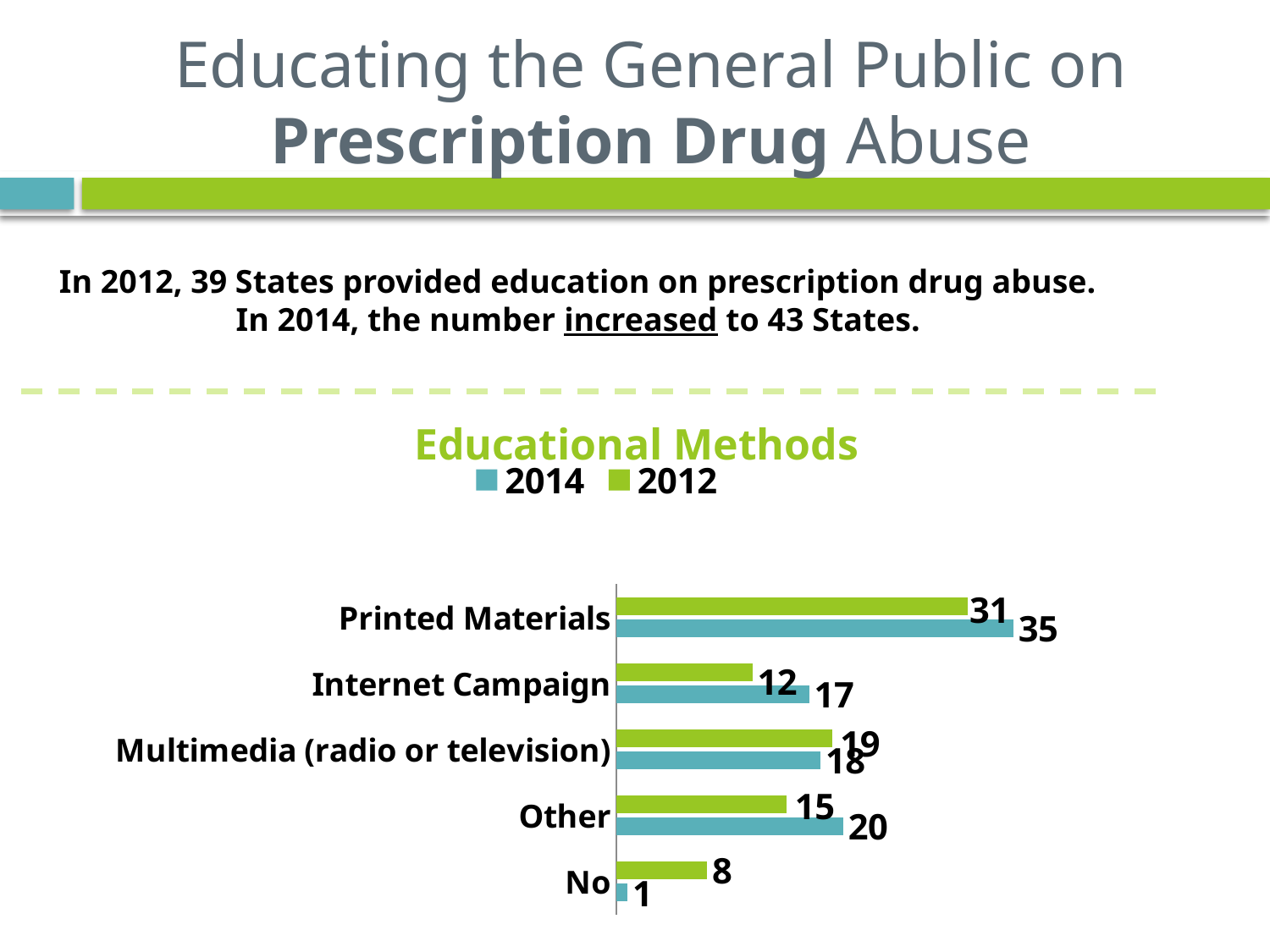
How many categories are shown in the Educational Methods chart? 5 What is the 2012 value for No? 8 What kind of chart is shown on the slide? Bar chart Which category has the lowest 2012 value? No What is the 2014 value for Printed Materials in the Educational Methods chart? 35 What is the difference between the 2014 and 2012 values for Printed Materials? 4 What is the difference between the 2014 and 2012 values for Internet Campaign? 5 What is the 2012 value for Internet Campaign? 12 Which educational method has the highest 2014 value? Printed Materials How many series does the legend list? 2 What is the 2014 value for Other? 20 Which is larger for Other: the 2014 value or the 2012 value? 2014